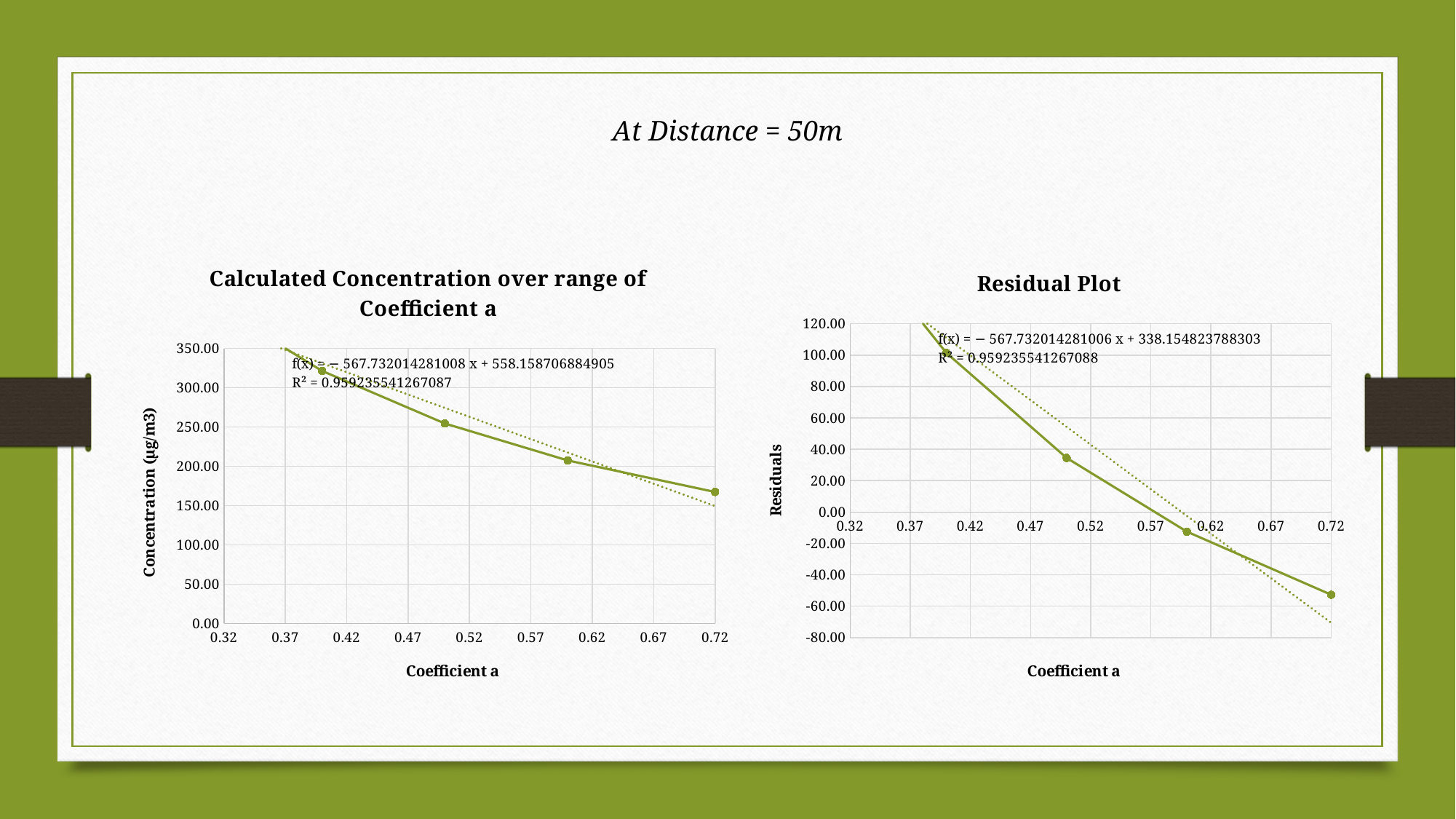
What kind of chart is the 'Calculated Concentration over range of Coefficient a' chart? line chart How many data points are plotted on the 'Calculated Concentration over range of Coefficient a' chart? 4 On the 'Calculated Concentration over range of Coefficient a' chart, do the values rise or fall as Coefficient a increases? fall What is the y-axis label of the 'Calculated Concentration over range of Coefficient a' chart? Concentration (µg/m3) On the 'Residual Plot' chart, is the residual of the leftmost data point greater or less than 80.00? greater On the 'Residual Plot' chart, do the residuals rise or fall as Coefficient a increases? fall On the 'Calculated Concentration over range of Coefficient a' chart, is the concentration at Coefficient a = 0.72 greater or less than 150.00? greater On the 'Residual Plot' chart, is the residual at Coefficient a = 0.72 greater or less than -40.00? less How many data points are plotted on the 'Residual Plot' chart? 4 What is the R² value shown on the 'Residual Plot' chart? 0.959235541267088